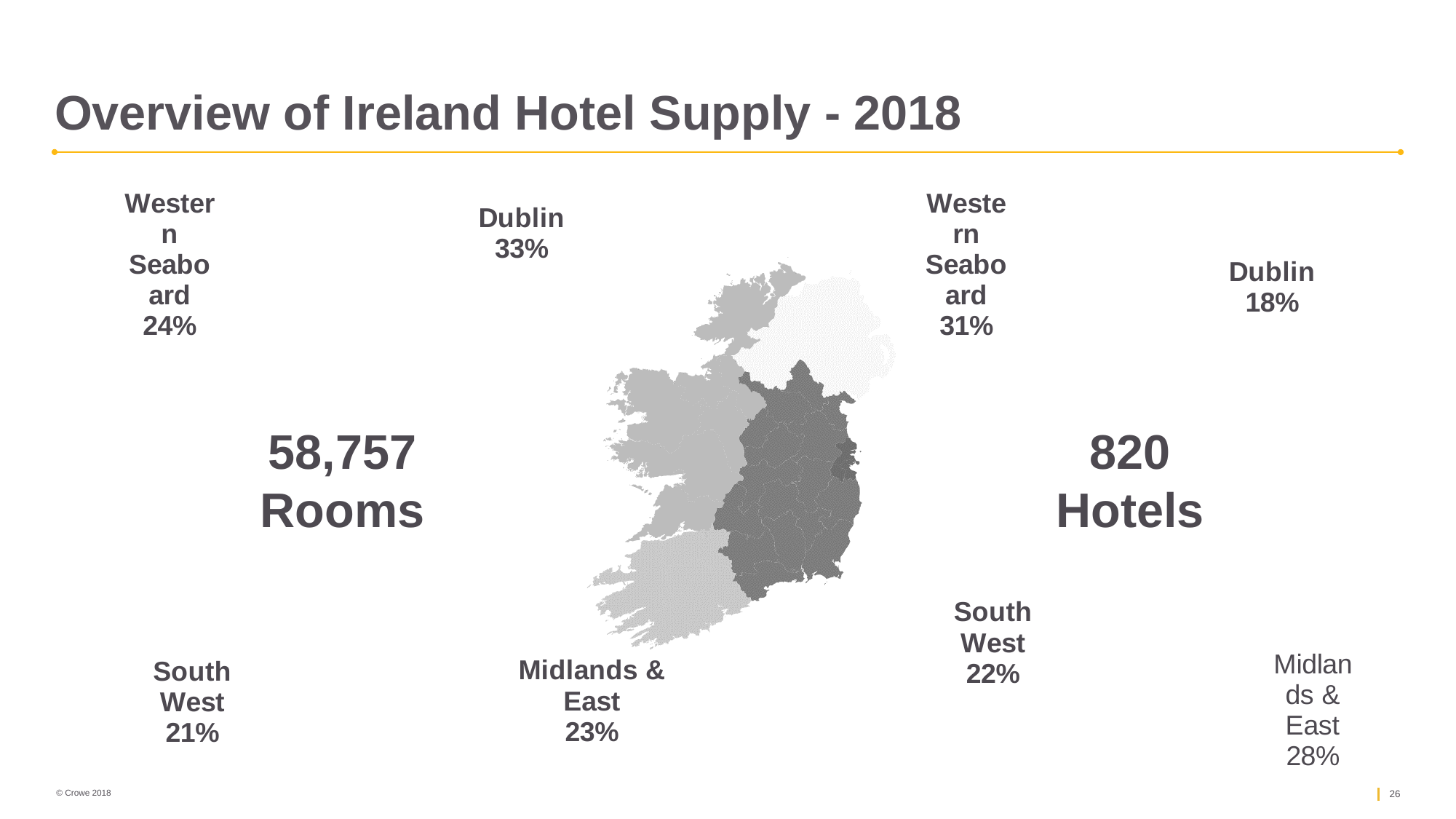
In the 58,757 Rooms chart, what is the difference in percentage points between Dublin and South West? 12 In the 820 Hotels chart, which has the larger share, South West or Midlands & East? Midlands & East How many regions are shown in the 58,757 Rooms chart? 4 In the 820 Hotels chart, what share of hotels is in Midlands & East? 28% In the 820 Hotels chart, what share of hotels is in Dublin? 18% In the 58,757 Rooms chart, what share of rooms is in Dublin? 33% In the 820 Hotels chart, which region has the smallest share? Dublin In the 820 Hotels chart, which region has the largest share? Western Seaboard In the 58,757 Rooms chart, what share of rooms is in the Western Seaboard? 24% In the 58,757 Rooms chart, which region has the smallest share? South West In the 58,757 Rooms chart, which region has the largest share? Dublin In the 820 Hotels chart, what is the difference in percentage points between Western Seaboard and Dublin? 13